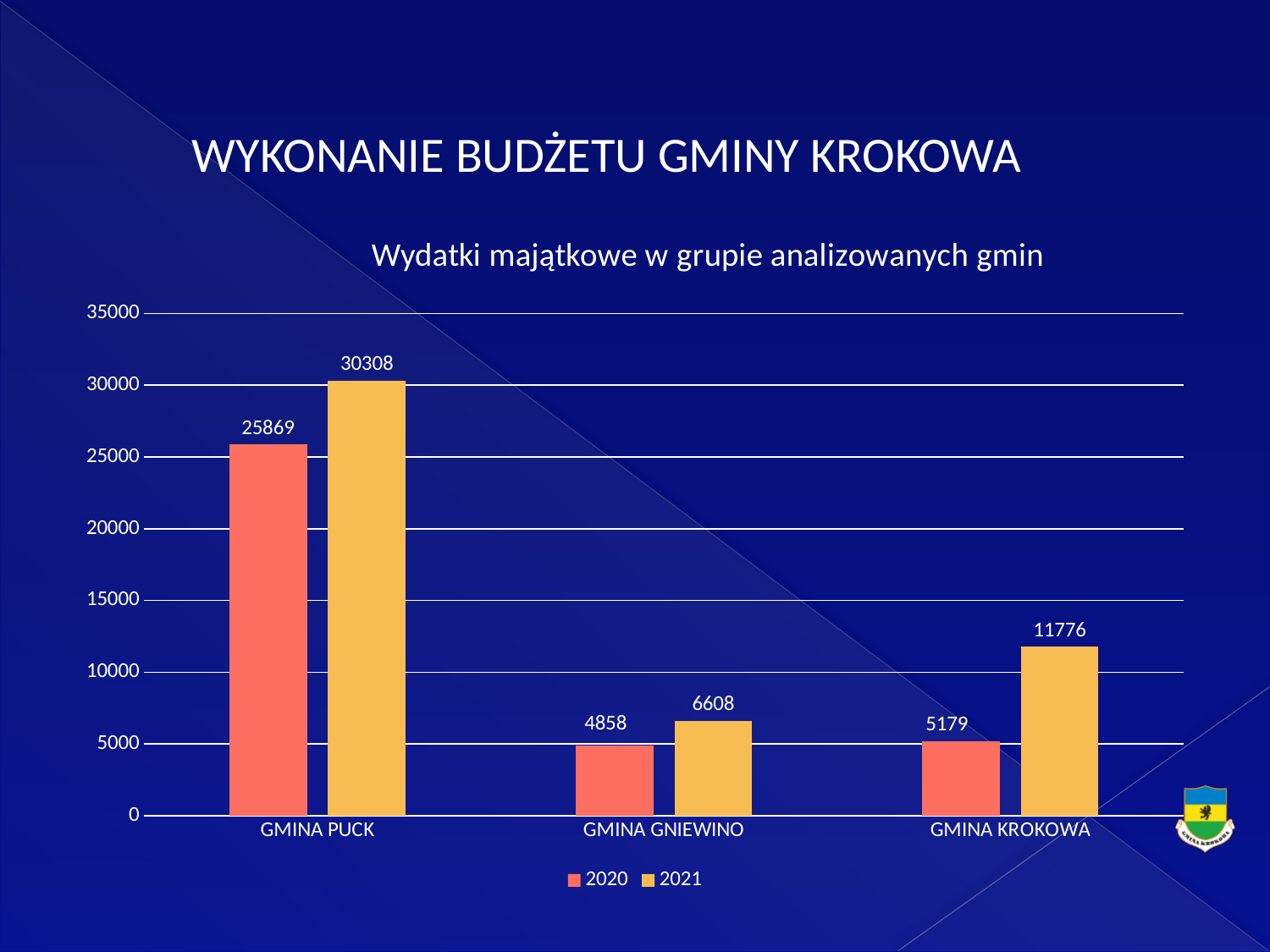
How many series does the legend list? 2 What is the title of the chart? Wydatki majątkowe w grupie analizowanych gmin What kind of chart is shown on the slide? bar chart What is the value for GMINA GNIEWINO in 2020? 4858 Which municipality has the highest value in 2020? GMINA PUCK What is the value for GMINA KROKOWA in 2021? 11776 How many municipalities are shown on the x axis? 3 Is the 2021 value for GMINA PUCK greater or less than 30000? greater What is the value for GMINA PUCK in 2021? 30308 What is the difference between the 2021 and 2020 values for GMINA KROKOWA? 6597 Which municipality has the lowest value in 2021? GMINA GNIEWINO Which is larger: the 2020 value for GMINA GNIEWINO or the 2020 value for GMINA KROKOWA? GMINA KROKOWA